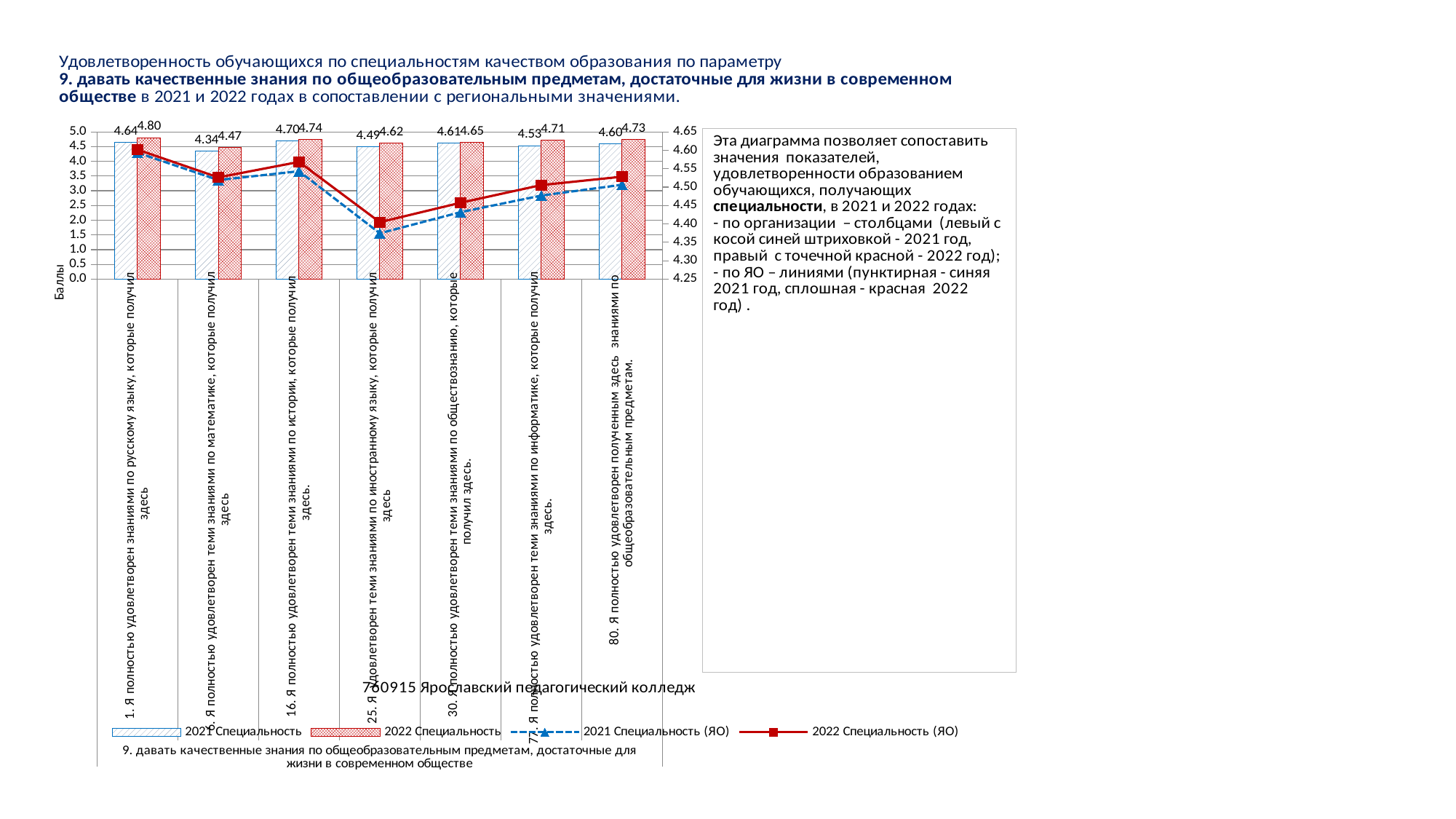
How many series does the chart legend list? 4 Which is larger for the category about иностранный язык (item 25): the 2021 Специальность value or the 2022 Специальность value? 2022 Специальность What is the label of the left vertical axis of the chart? Баллы Which category has the highest 2022 Специальность value? 1. Я полностью удовлетворен знаниями по русскому языку, которые получил здесь What is the 2022 Специальность value for the category about русский язык (item 1)? 4.80 How many categories are shown on the x axis of the chart? 7 What is the difference between the 2022 and 2021 Специальность values for the category about информатика (item 77)? 0.18 What kind of chart is shown on the slide? Combined bar and line chart Is the 2022 Специальность (ЯО) value for the category about иностранный язык (item 25) greater or less than 4.45 on the right axis? less What is the 2022 Специальность value for the category about информатика (item 77)? 4.71 Which category has the lowest 2021 Специальность value? 6. Я полностью удовлетворен теми знаниями по математике, которые получил здесь